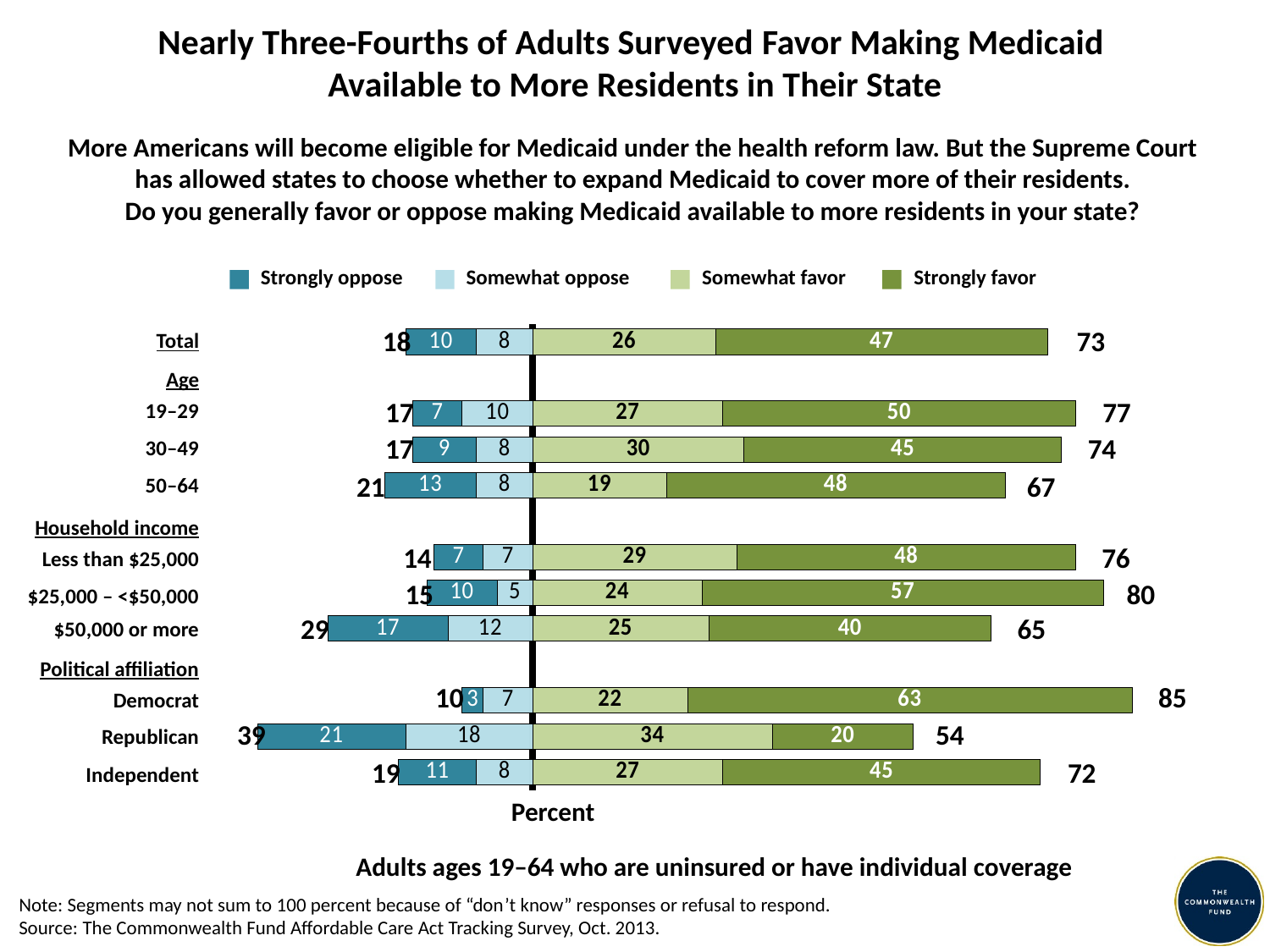
Which category has the lowest Strongly favor value? Republican How many series does the legend list? 4 What is the difference between the Strongly favor values for Democrats and Republicans? 43 What kind of chart is shown on the slide? Stacked bar chart What is the Strongly favor value for the Total category? 47 What is the Strongly oppose value for the $50,000 or more income group? 17 What is the combined favor total (Somewhat favor plus Strongly favor) shown for the $25,000 – <$50,000 group? 80 Which category has the highest Strongly favor value? Democrat What is the Somewhat oppose value for Republicans? 18 Which is larger, the Somewhat favor value for 30–49 or for 50–64? 30–49 How many categories (rows) are plotted in the chart? 10 What is the combined oppose total shown for Republicans? 39